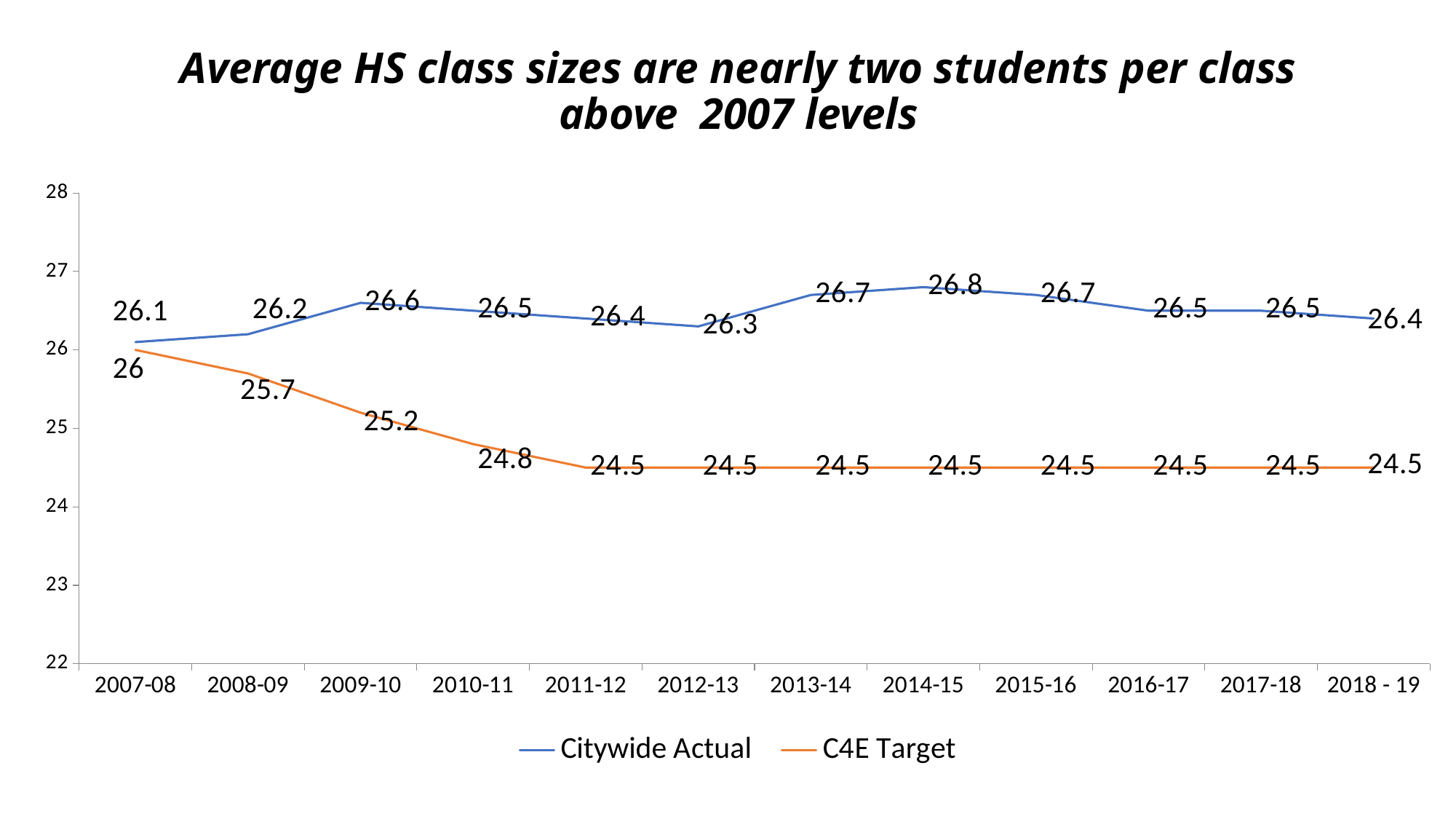
Which is larger in 2010-11, the Citywide Actual value or the C4E Target value? Citywide Actual What is the difference between the Citywide Actual and C4E Target values in 2018 - 19? 1.9 How many series does the legend list? 2 What is the C4E Target value for 2009-10? 25.2 Is the C4E Target value for 2011-12 greater or less than 25? less In which year is the Citywide Actual value highest? 2014-15 What is the Citywide Actual value for 2007-08? 26.1 What is the Citywide Actual value for 2014-15? 26.8 Does the C4E Target value rise or fall from 2007-08 to 2011-12? fall In which year is the Citywide Actual value lowest? 2007-08 How many school years are shown on the x axis? 12 What kind of chart is shown on the slide? line chart